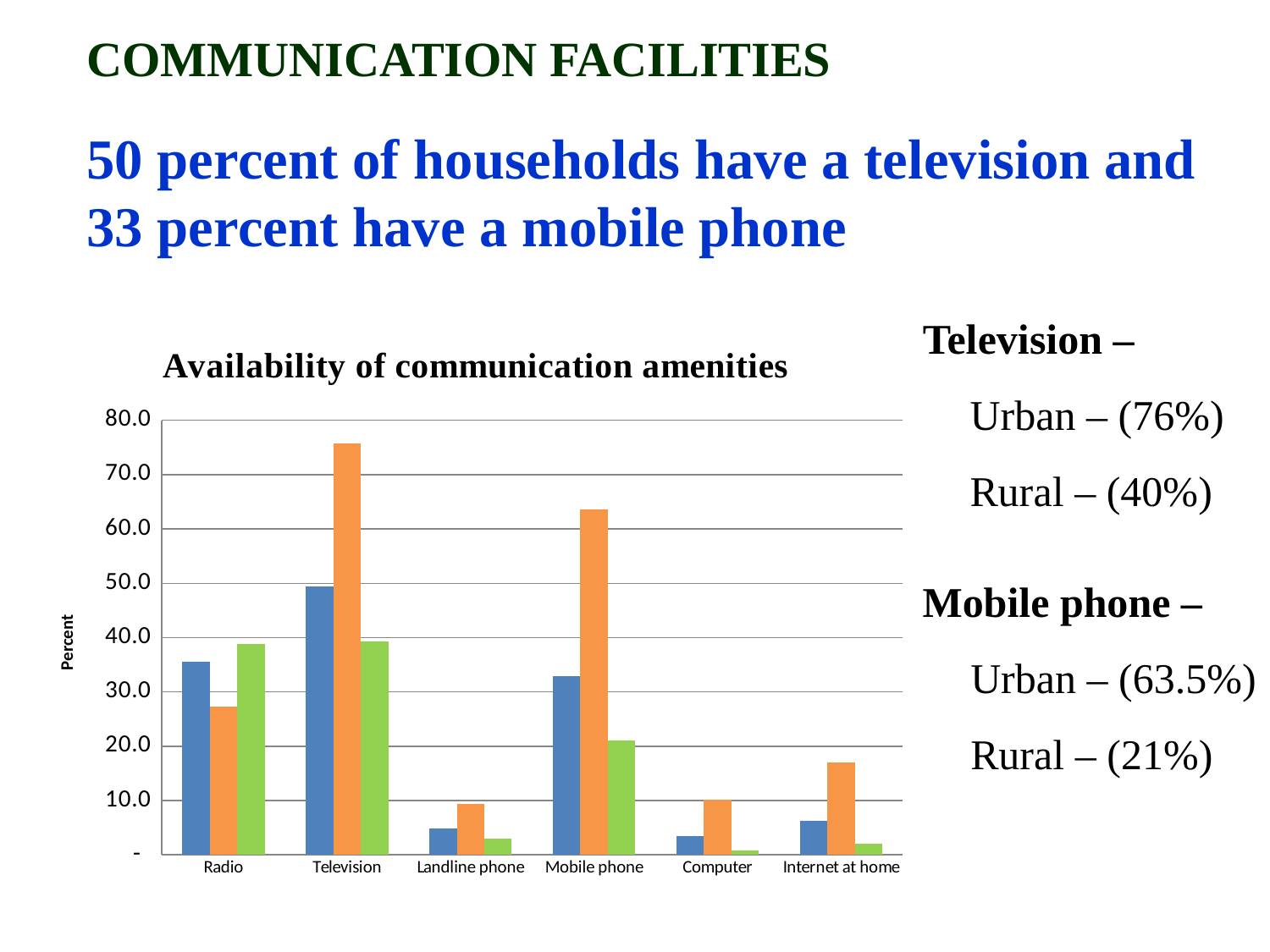
Is the orange bar for Mobile phone greater or less than 60.0? greater What kind of chart is shown on the slide? bar chart How many categories are shown along the x axis of the chart? 6 What is the label on the vertical axis of the chart? Percent For Radio, which is larger: the blue bar or the orange bar? the blue bar Which is larger: the orange bar for Television or the orange bar for Mobile phone? Television What is the title of the chart? Availability of communication amenities Which category has the tallest orange bar? Television Which category has the shortest blue bar? Computer Which category has the tallest blue bar? Television Is the green bar for Mobile phone greater or less than 30.0? less Is the orange bar for Television greater or less than 70.0? greater